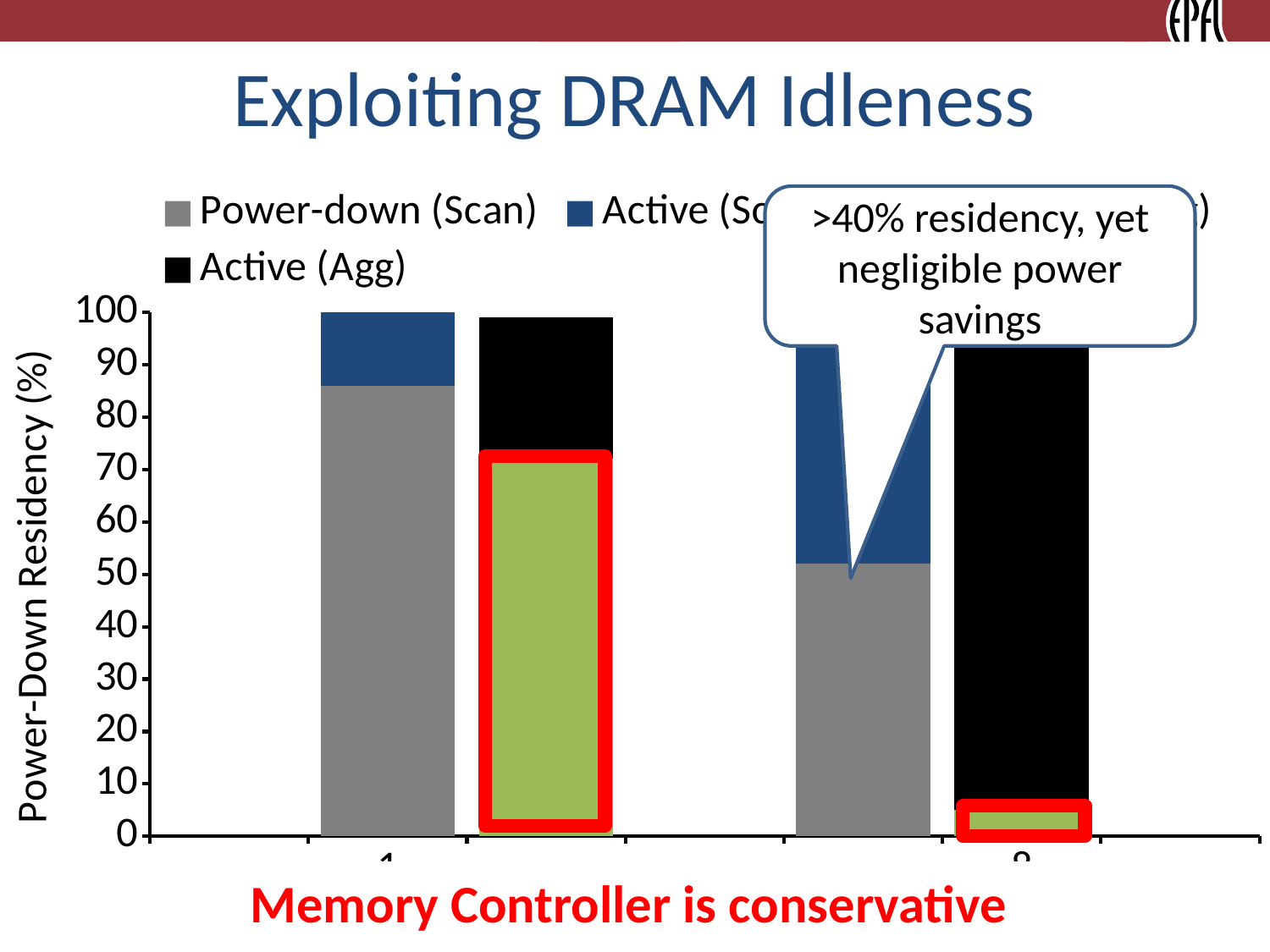
How many groups of bars are shown along the x axis? 2 Is the green (Agg power-down) segment in the left group greater or less than 60? greater Is the Power-down (Scan) value in the left group of bars greater or less than 80? greater Which group has the larger Power-down (Scan) value, the left group or the right group? Left group In the right group of bars, which segment is the largest? Active (Agg) How many stacked bars are plotted in the chart? 4 Is the green (Agg power-down) segment in the right group greater or less than 10? less What kind of chart is shown on the slide? Stacked bar chart What is the title of the vertical axis? Power-Down Residency (%) What colour represents the Power-down (Scan) series in the legend? Gray Which group has the larger green (Agg power-down) segment, the left group or the right group? Left group